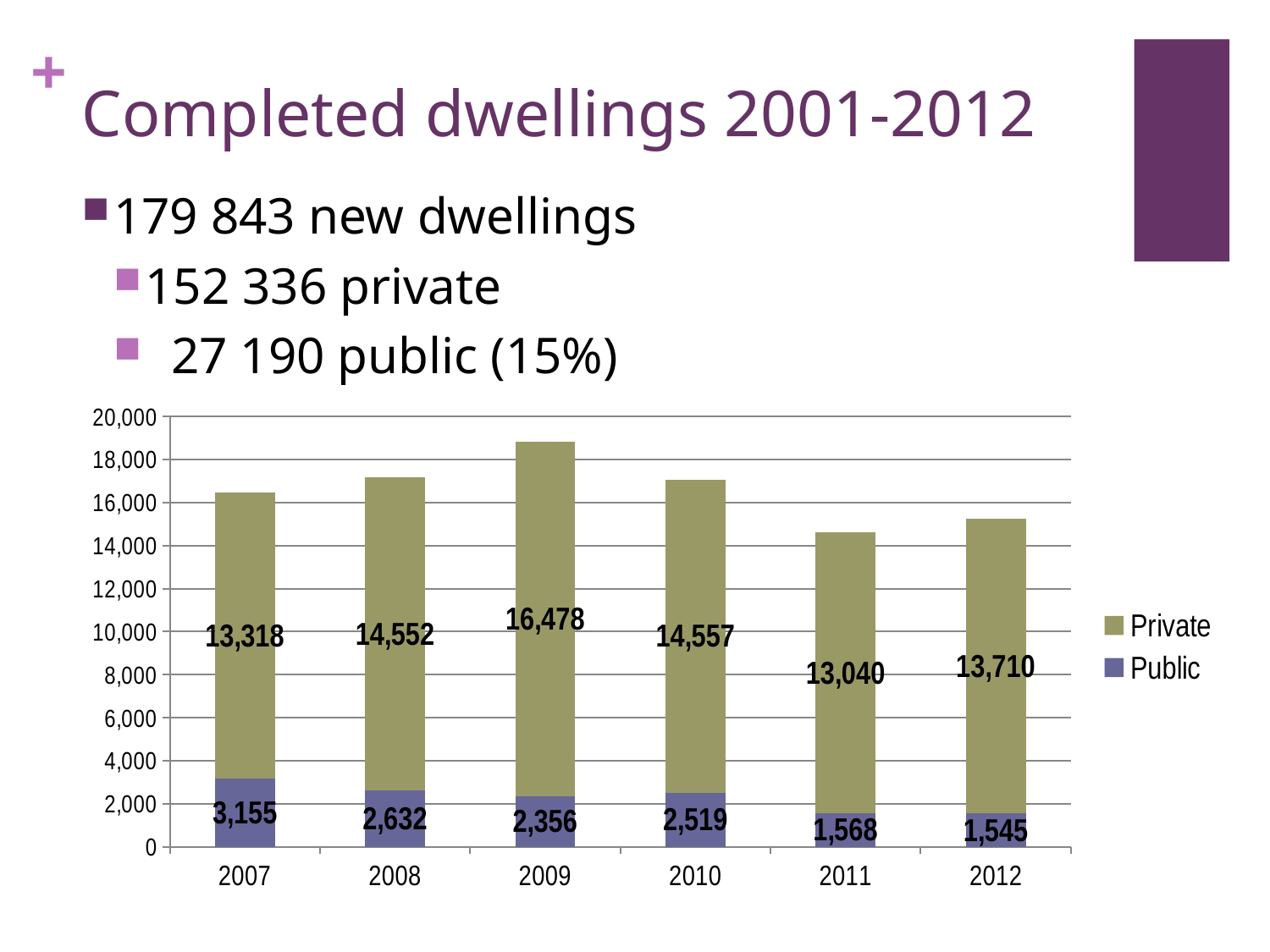
What is the Private value for 2012? 13,710 Is the total stacked bar for 2009 greater or less than 18,000? greater What is the total of the stacked bar for 2007? 16,473 How many years are shown on the x axis? 6 What is the difference between the Private values for 2009 and 2011? 3,438 What kind of chart is shown on the slide? Stacked bar chart Which year has the highest Private value? 2009 Which year has the lowest Public value? 2012 Which is larger, the Public value for 2007 or the Public value for 2010? 2007 What is the Public value for 2011? 1,568 What is the Private value for 2009? 16,478 How many series does the legend list? 2